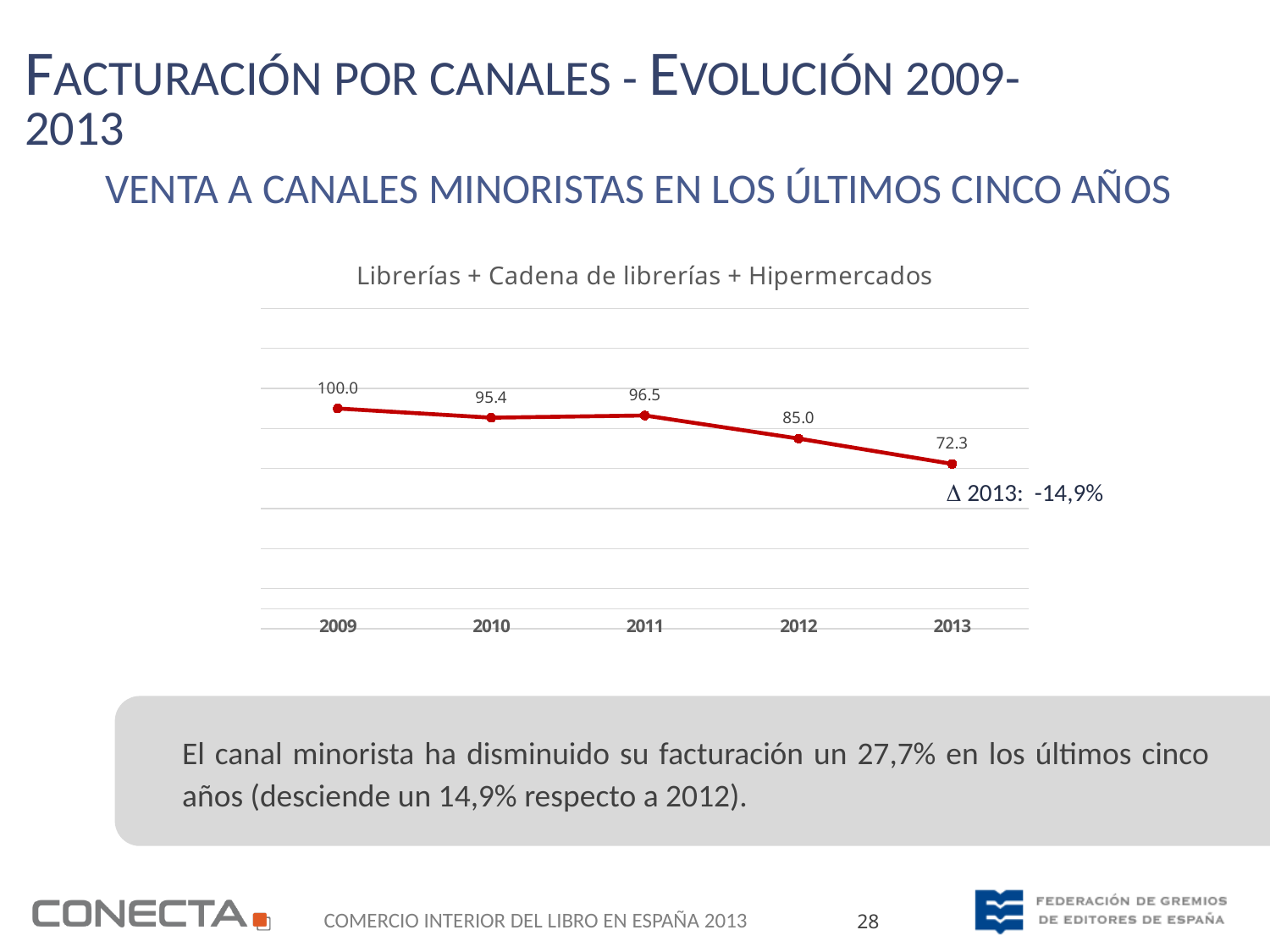
Which is larger, the value for 2010 or the value for 2011? 2011 Do the values generally rise or fall from 2009 to 2013? fall What is the value for 2009? 100.0 Which year has the lowest value? 2013 What is the value for 2011? 96.5 What is the difference between the values for 2012 and 2013? 12.7 What kind of chart is shown? line chart What is the title of the chart? Librerías + Cadena de librerías + Hipermercados Which year has the highest value? 2009 What is the value for 2013? 72.3 What is the value for 2012? 85.0 How many years are plotted on the chart? 5